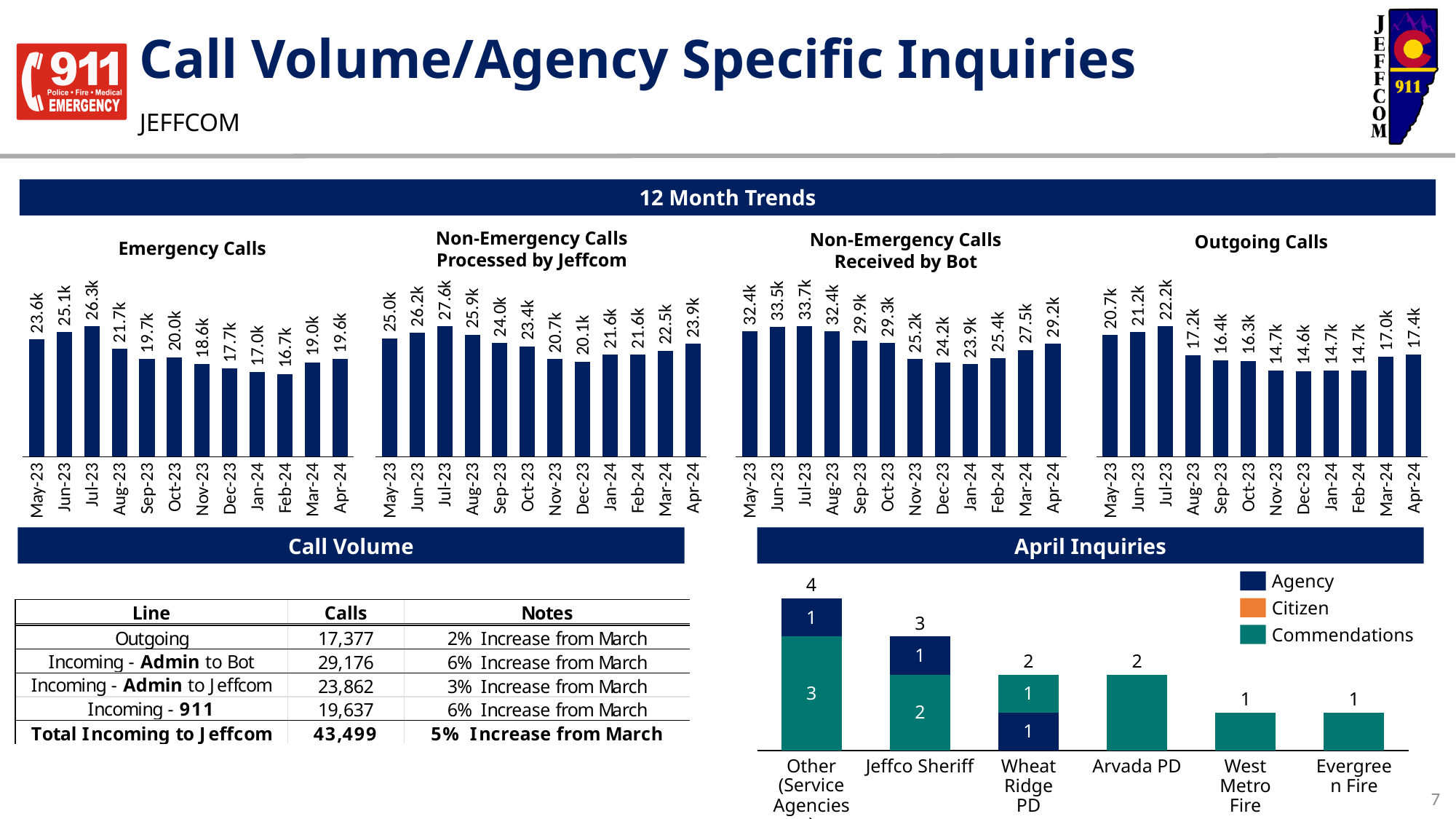
How many series does the legend of the April Inquiries chart list? 3 In the Emergency Calls chart, which month has the lowest value? Feb-24 In the Non-Emergency Calls Processed by Jeffcom chart, what is the value for Apr-24? 23.9k In the Non-Emergency Calls Received by Bot chart, what is the difference between Jul-23 and Jan-24? 9.8k In the Emergency Calls chart, what is the value for Jul-23? 26.3k What kind of chart is the April Inquiries chart? Stacked bar chart In the April Inquiries chart, what is the total for Other (Service Agencies)? 4 In the April Inquiries chart, how many Commendations does Jeffco Sheriff have? 2 How many months are shown in the Outgoing Calls chart? 12 In the Non-Emergency Calls Processed by Jeffcom chart, which month has the highest value? Jul-23 In the Non-Emergency Calls Received by Bot chart, which is larger, Mar-24 or Apr-24? Apr-24 In the Outgoing Calls chart, what is the value for Dec-23? 14.6k